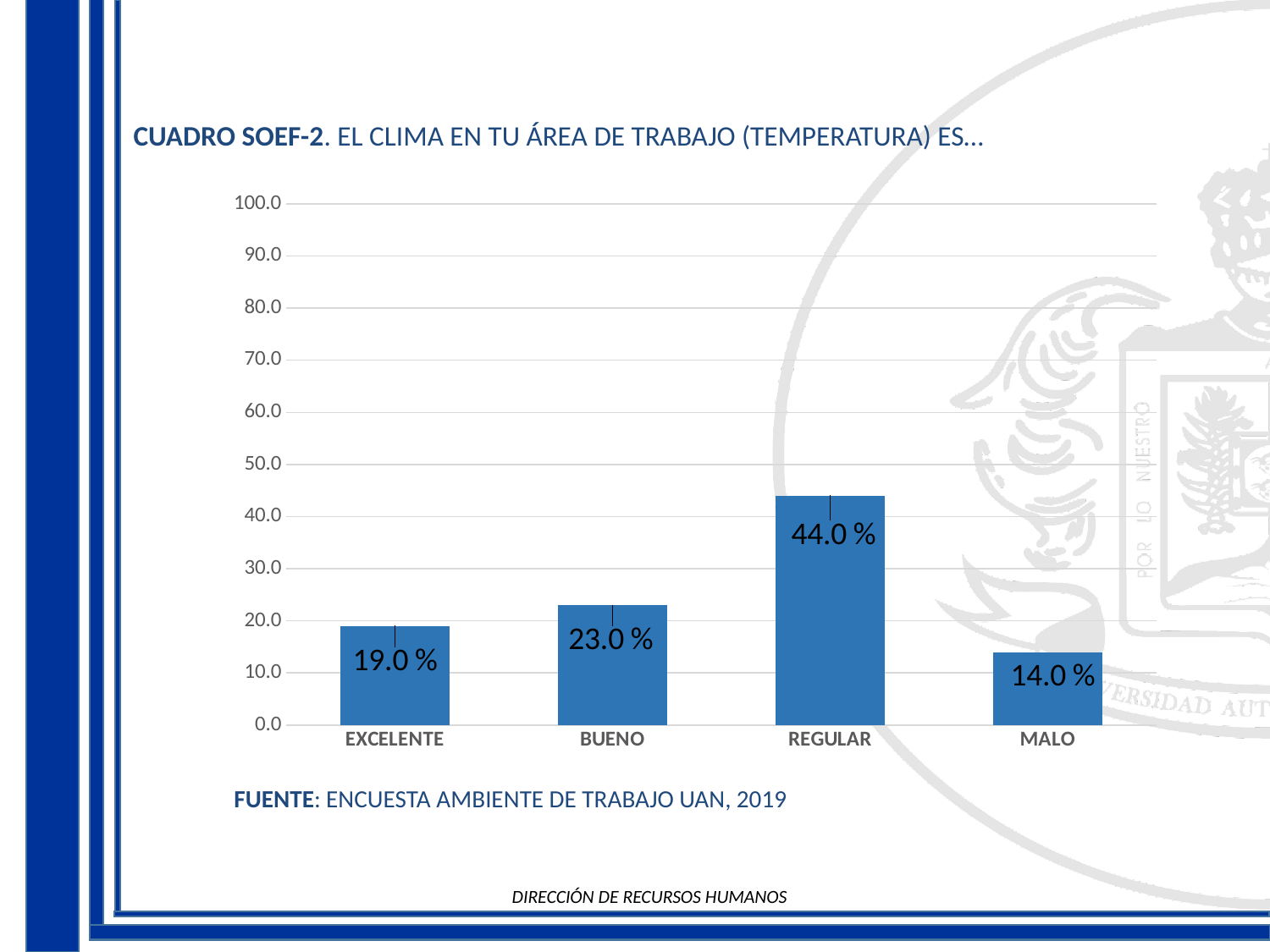
What kind of chart is shown on the slide? bar chart What is the value for EXCELENTE? 19.0 % Which category has the lowest value? MALO Which category has the highest value? REGULAR How many categories are shown on the x axis? 4 What is the difference between the values for REGULAR and BUENO? 21.0 % What is the value for REGULAR? 44.0 % What is the value for MALO? 14.0 % What is the value for BUENO? 23.0 % Which is larger, the value for EXCELENTE or the value for BUENO? BUENO What source is cited below the chart? ENCUESTA AMBIENTE DE TRABAJO UAN, 2019 Is the value for REGULAR greater or less than 50.0? less